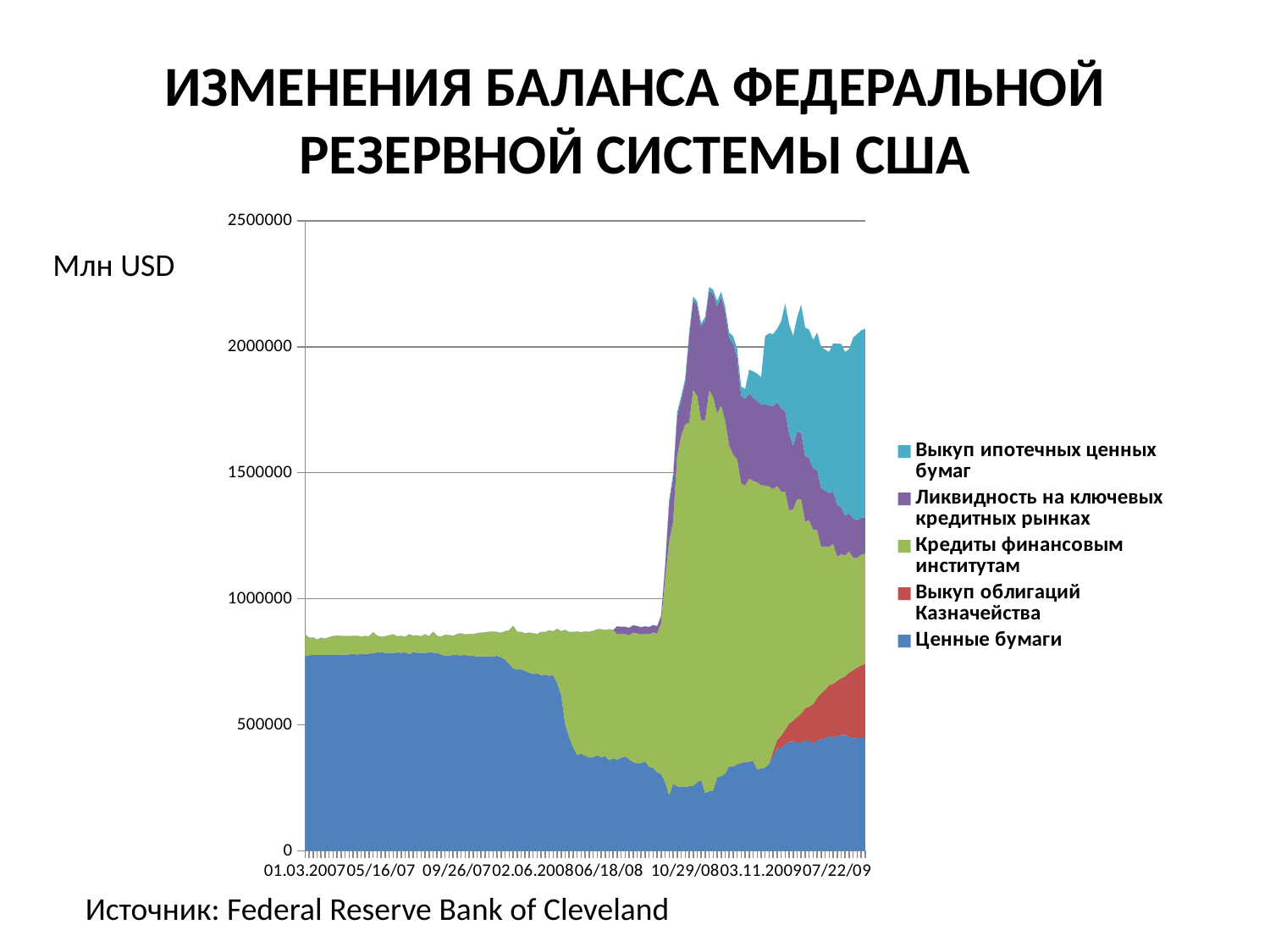
What unit is shown for the vertical axis? Млн USD Is the total balance at the end of the period (after 07/22/09) greater or less than 1500000? greater Is the value for Ценные бумаги around 10/29/08 greater or less than 500000? less Is the total balance at the start of the period (01.03.2007) greater or less than 1000000? less Does the value for Ценные бумаги rise or fall from 01.03.2007 to 10/29/08? fall How many date labels are shown along the x axis? 8 How many series does the legend list? 5 What is the title of the chart? ИЗМЕНЕНИЯ БАЛАНСА ФЕДЕРАЛЬНОЙ РЕЗЕРВНОЙ СИСТЕМЫ США Does the total balance rise or fall between 06/18/08 and 10/29/08? rise What kind of chart is shown on the slide? Stacked area chart What is the highest value shown on the vertical axis? 2500000